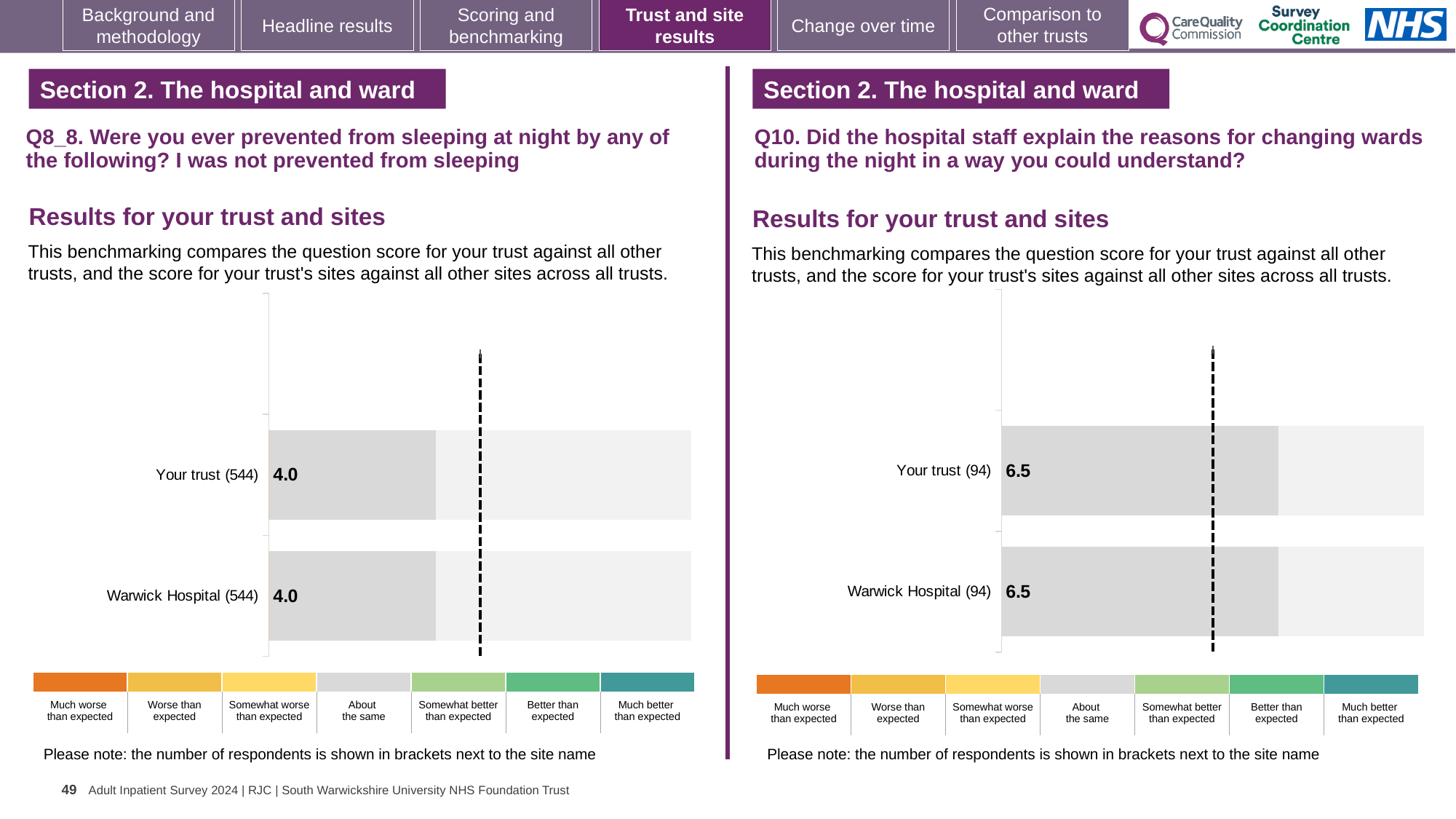
On the right chart (Q10), what is the difference between the Your trust score and the Warwick Hospital score? 0.0 On the left chart (Q8_8), how many bars are plotted? 2 What kind of chart is used on the left (Q8_8)? Bar chart On the left chart (Q8_8), what is the score for Your trust? 4.0 On the right chart (Q10), how many bars are plotted? 2 On the right chart (Q10), how many respondents are shown in brackets next to Warwick Hospital? 94 On the right chart (Q10), what is the score for Warwick Hospital? 6.5 On the left chart (Q8_8), how many respondents are shown in brackets next to Your trust? 544 On the left chart (Q8_8), what is the difference between the Your trust score and the Warwick Hospital score? 0.0 Is the Your trust score on the right chart (Q10) larger or smaller than the Your trust score on the left chart (Q8_8)? Larger On the left chart (Q8_8), what is the score for Warwick Hospital? 4.0 On the right chart (Q10), what is the score for Your trust? 6.5